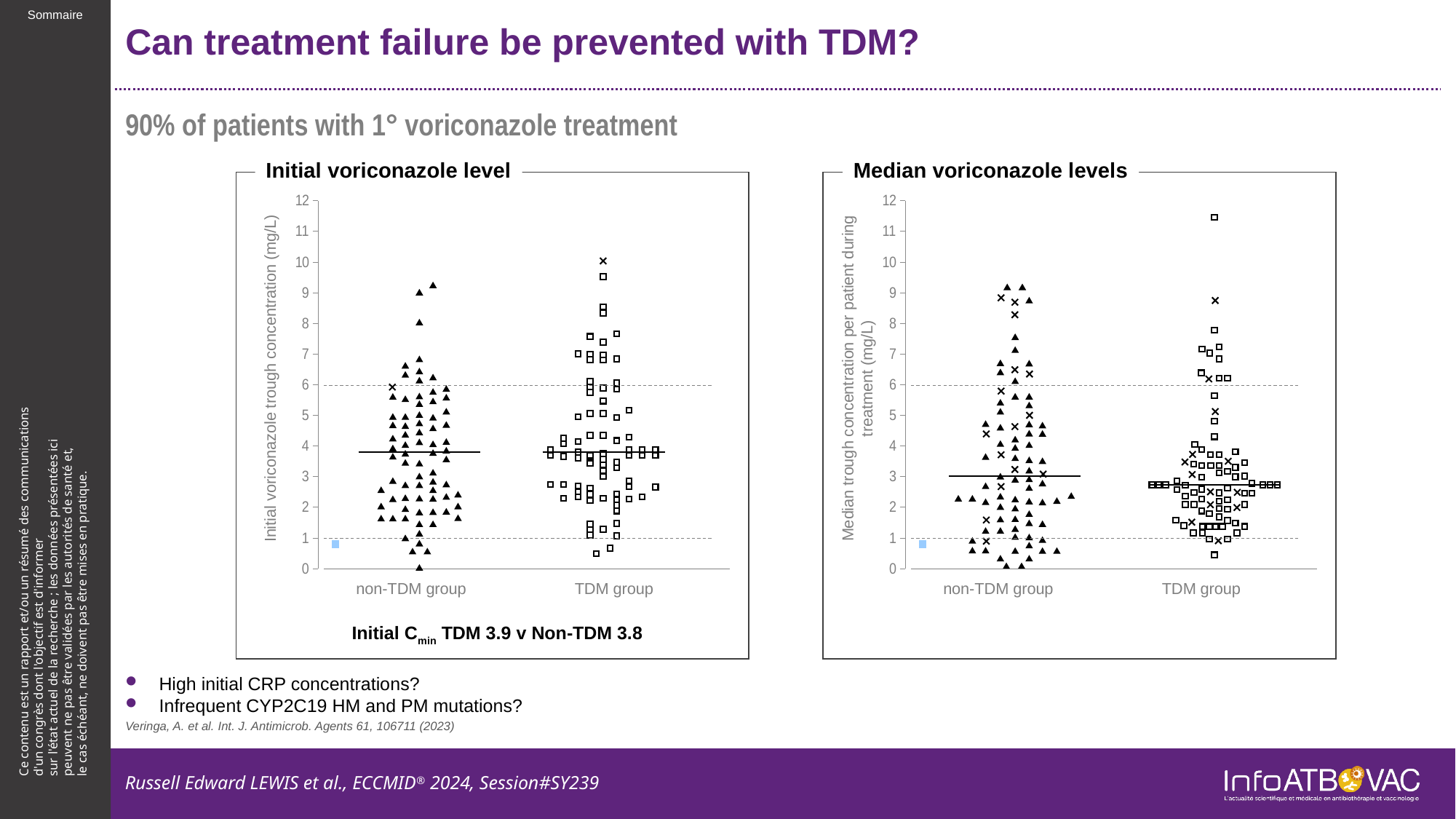
In the 'Initial voriconazole level' chart, is the highest point in the TDM group greater or less than 9 mg/L? greater What is the maximum value shown on the y axis of the 'Median voriconazole levels' chart? 12 In the 'Initial voriconazole level' chart, which group has the higher stated initial Cmin, TDM or Non-TDM? TDM In the 'Initial voriconazole level' chart, what is the difference between the stated initial Cmin of the TDM group and the Non-TDM group? 0.1 How many patient groups are shown on the x axis of the 'Median voriconazole levels' chart? 2 What is the y-axis label of the 'Initial voriconazole level' chart? Initial voriconazole trough concentration (mg/L) What kind of chart is the 'Initial voriconazole level' chart? Scatter (dot) plot In the 'Median voriconazole levels' chart, is the highest point in the TDM group greater or less than 11 mg/L? greater In the 'Initial voriconazole level' chart, what initial Cmin value is stated for the TDM group? 3.9 In the 'Median voriconazole levels' chart, is the highest point in the non-TDM group greater or less than 10 mg/L? less In the 'Initial voriconazole level' chart, what initial Cmin value is stated for the Non-TDM group? 3.8